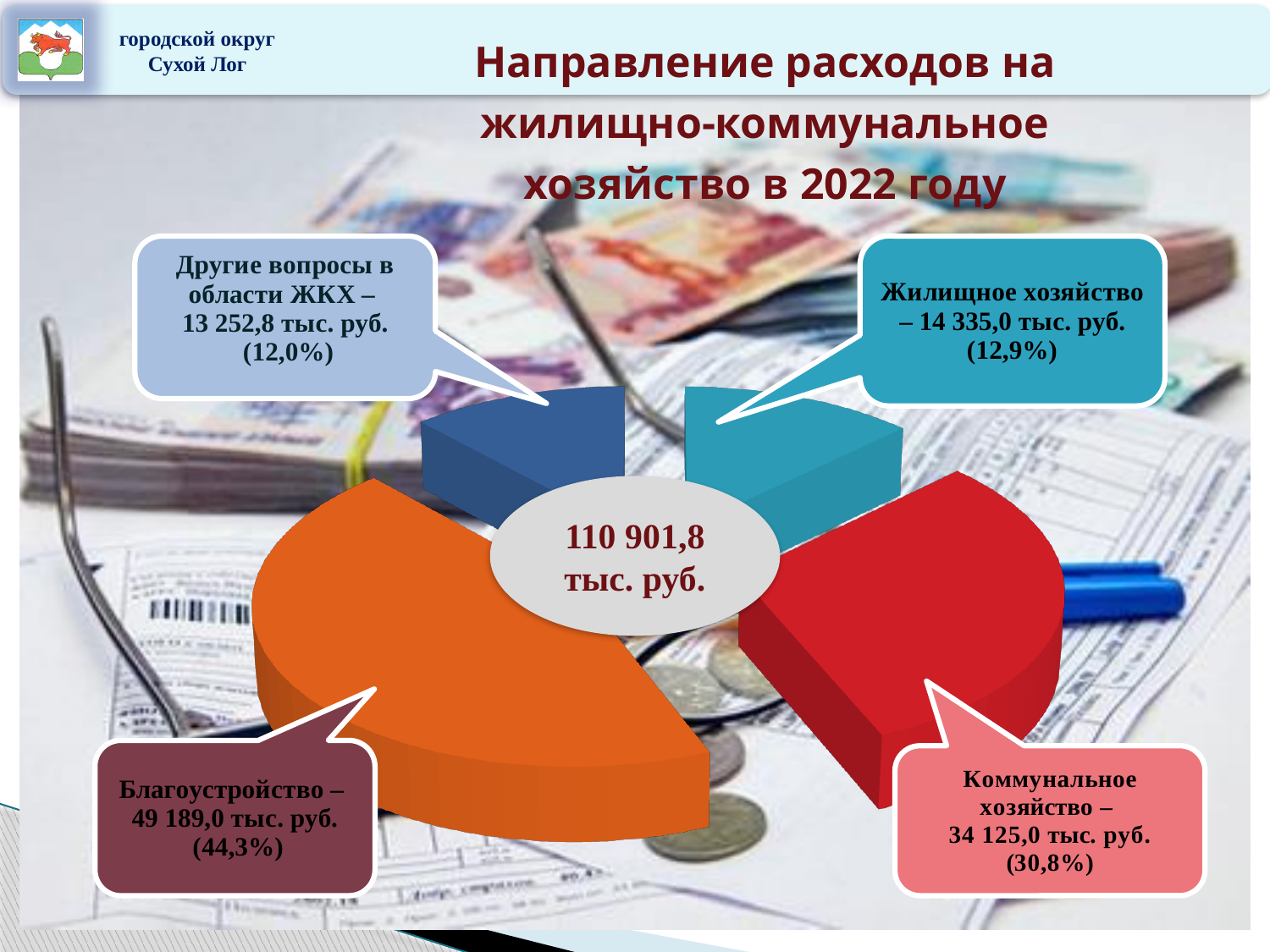
What is the value for Коммунальное хозяйство? 34 125,0 тыс. руб. What is the value for Другие вопросы в области ЖКХ? 13 252,8 тыс. руб. How many slices does the pie chart have? 4 What total value is shown in the centre of the pie chart? 110 901,8 тыс. руб. What is the difference between the values for Благоустройство and Коммунальное хозяйство? 15 064,0 тыс. руб. What is the value for Благоустройство? 49 189,0 тыс. руб. What is the value for Жилищное хозяйство? 14 335,0 тыс. руб. Which category has the largest slice of the pie? Благоустройство What share of the pie does Благоустройство represent? 44,3% Which category has the smallest slice of the pie? Другие вопросы в области ЖКХ What share of the pie does Жилищное хозяйство represent? 12,9% What kind of chart is shown on the slide? pie chart